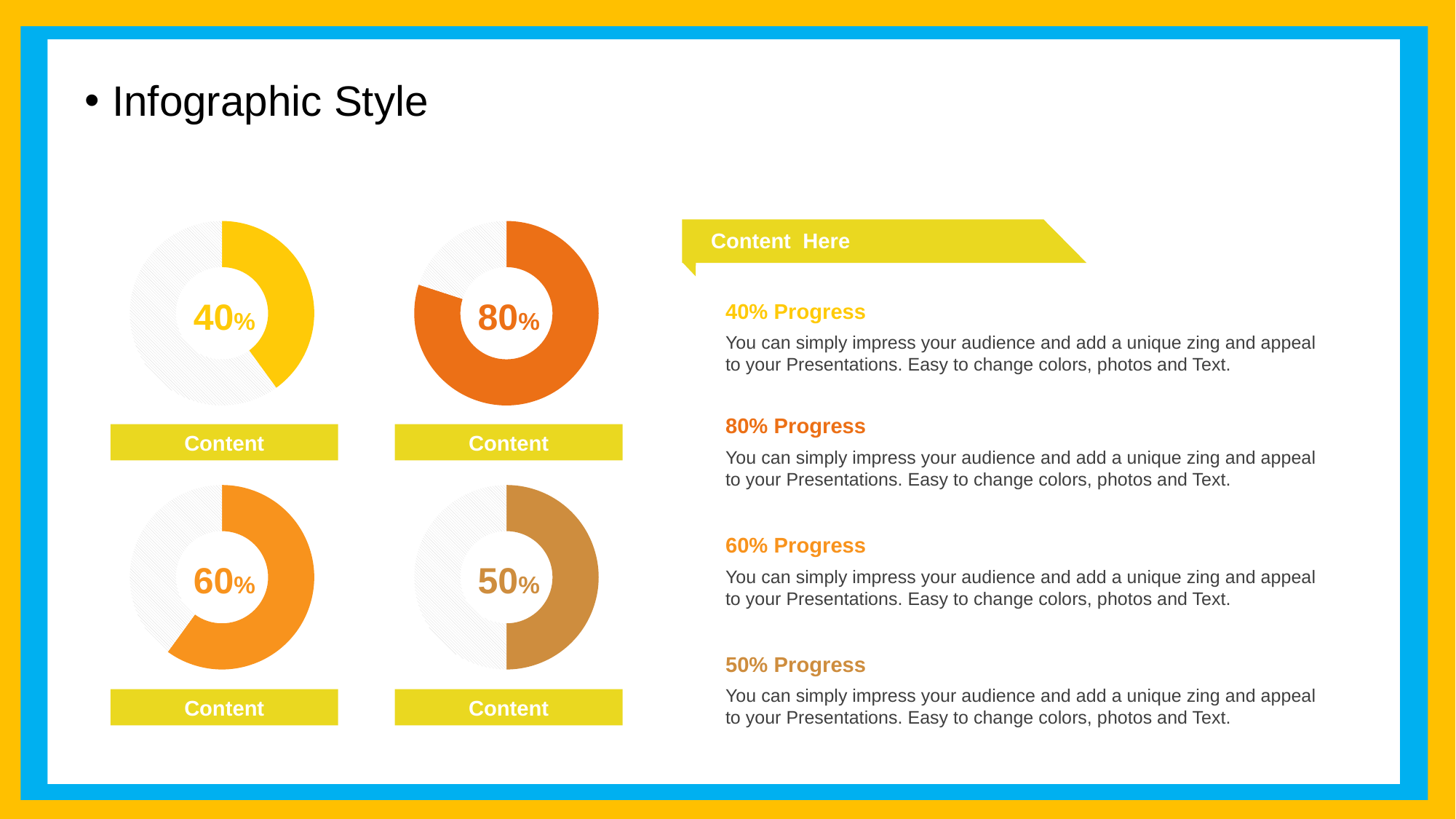
What colour is the filled portion of the top-right donut chart? Orange Which of the four donut charts shows the highest percentage? The top-right chart (80%) Which shows a larger percentage, the bottom-left donut chart or the bottom-right donut chart? The bottom-left chart (60%) What value is shown in the centre of the top-right donut chart? 80% What value is shown in the centre of the bottom-left donut chart? 60% What value is shown in the centre of the top-left donut chart? 40% What label appears in the box beneath each donut chart? Content What value is shown in the centre of the bottom-right donut chart? 50% What is the difference between the percentage in the top-right donut chart and the percentage in the top-left donut chart? 40% What kind of chart is used to show the percentages on the slide? Donut chart Which of the four donut charts shows the lowest percentage? The top-left chart (40%) How many donut charts are on the slide? 4